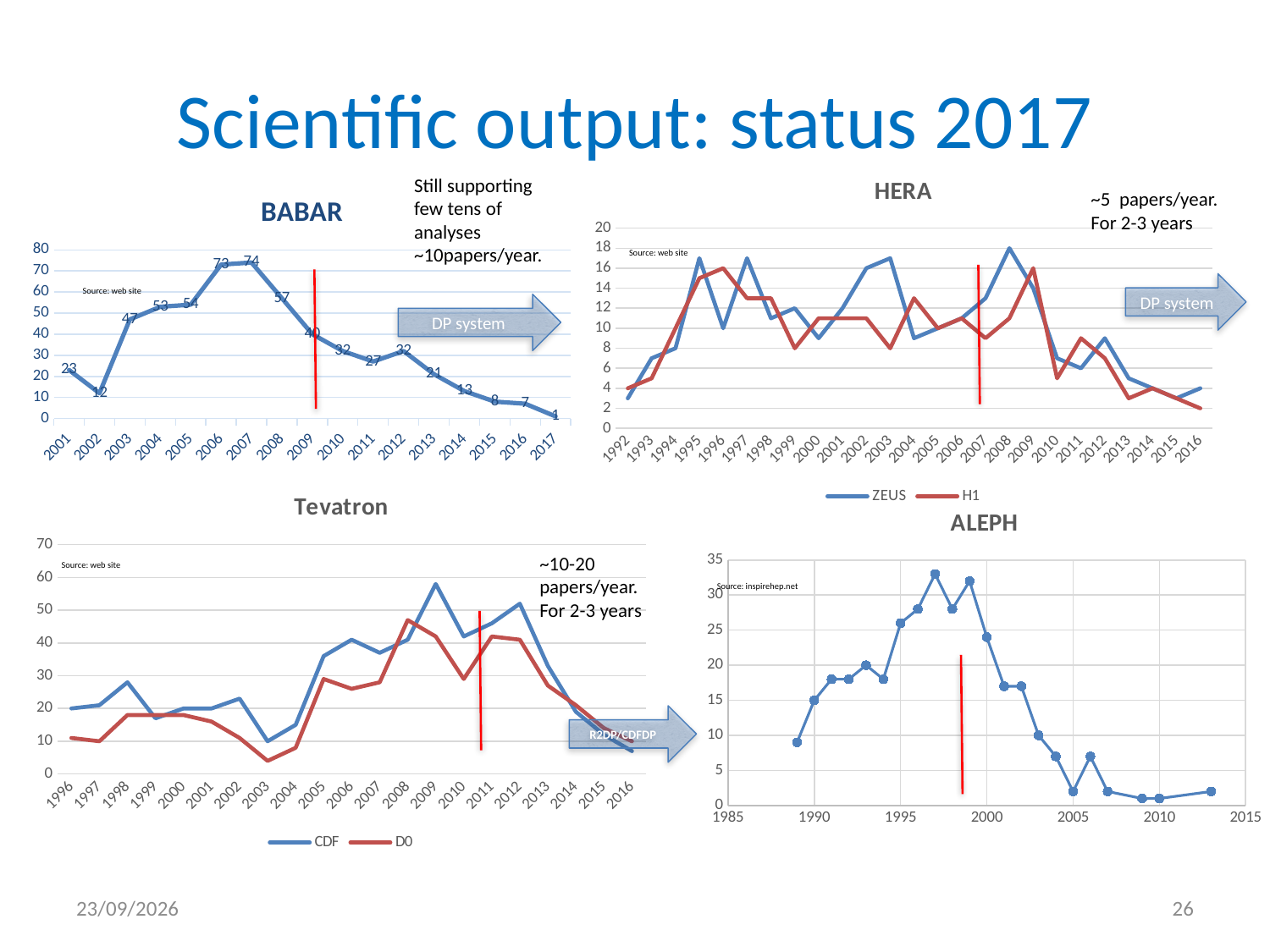
In the HERA chart, is the ZEUS value for 2008 greater or less than 16? greater In the BABAR chart, what is the value for 2007? 74 What are the two series named in the legend of the Tevatron chart? CDF and D0 In the BABAR chart, how many years are plotted on the x axis? 17 In the Tevatron chart, is the CDF value for 2009 greater or less than 50? greater How many series does the legend of the HERA chart list? 2 In the BABAR chart, which year has the lowest value? 2017 In the BABAR chart, which year has the highest value? 2007 In the BABAR chart, what is the value for 2001? 23 In the ALEPH chart, is the value for 1997 greater or less than 30? greater In the BABAR chart, what is the difference between the values for 2006 and 2009? 33 What kind of chart is the BABAR chart? line chart